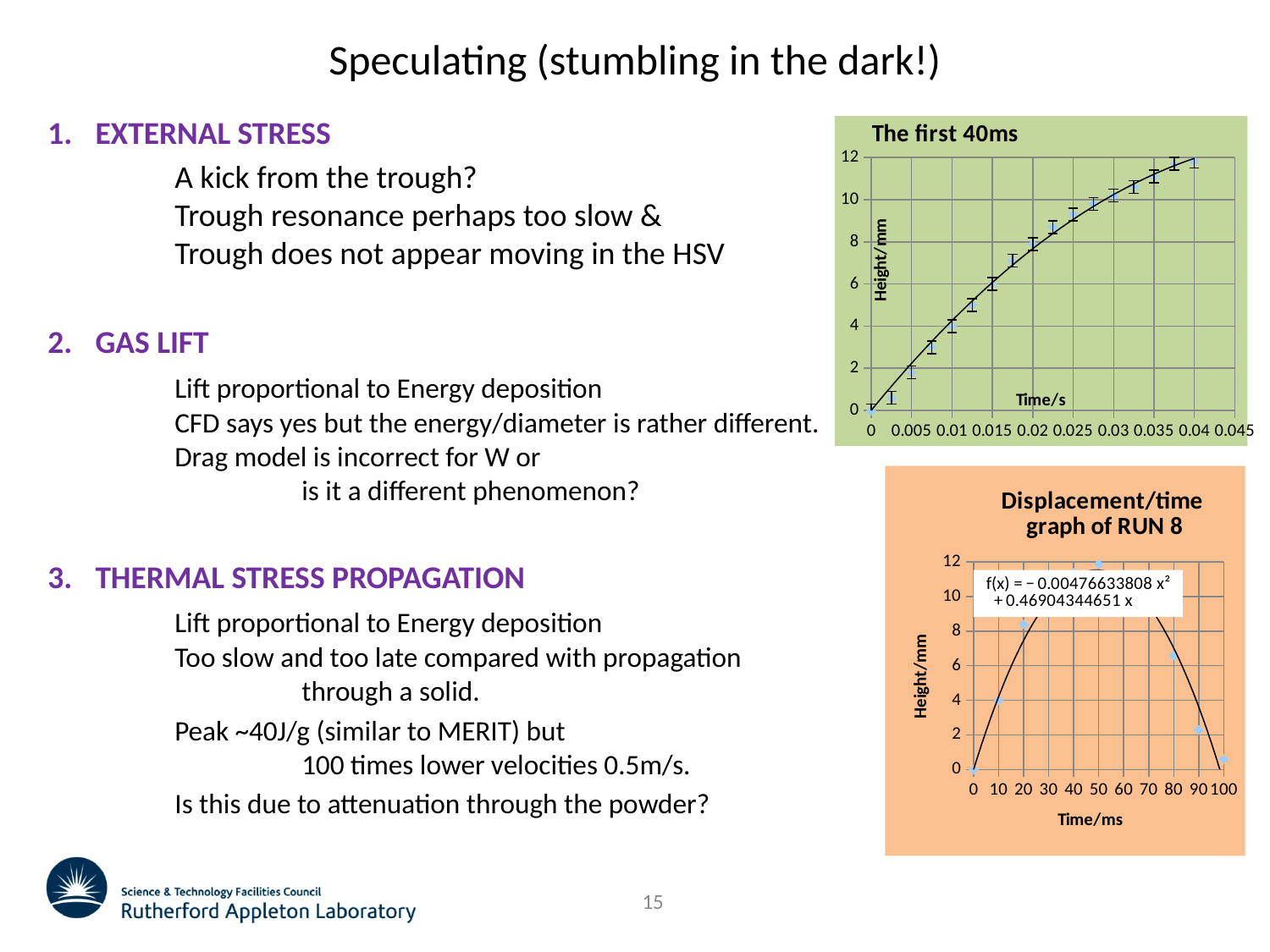
In "The first 40ms" chart, do the height values rise or fall as time increases? rise What kind of chart is "The first 40ms"? scatter chart with a fitted curve In the "Displacement/time graph of RUN 8", how does the height change as time goes from 0 to 100 ms? rises then falls What fitted equation is shown on the "Displacement/time graph of RUN 8"? f(x) = − 0.00476633808 x² + 0.46904344651 x What kind of chart is the "Displacement/time graph of RUN 8"? scatter chart with a fitted curve In "The first 40ms" chart, is the height at 0.04 s greater or less than 10 mm? greater What is the label of the x axis in "The first 40ms" chart? Time/s In the "Displacement/time graph of RUN 8", is the height at 50 ms greater or less than 10 mm? greater In "The first 40ms" chart, is the height at 0.005 s greater or less than 4 mm? less In the "Displacement/time graph of RUN 8", which is larger, the height at 20 ms or the height at 90 ms? 20 ms